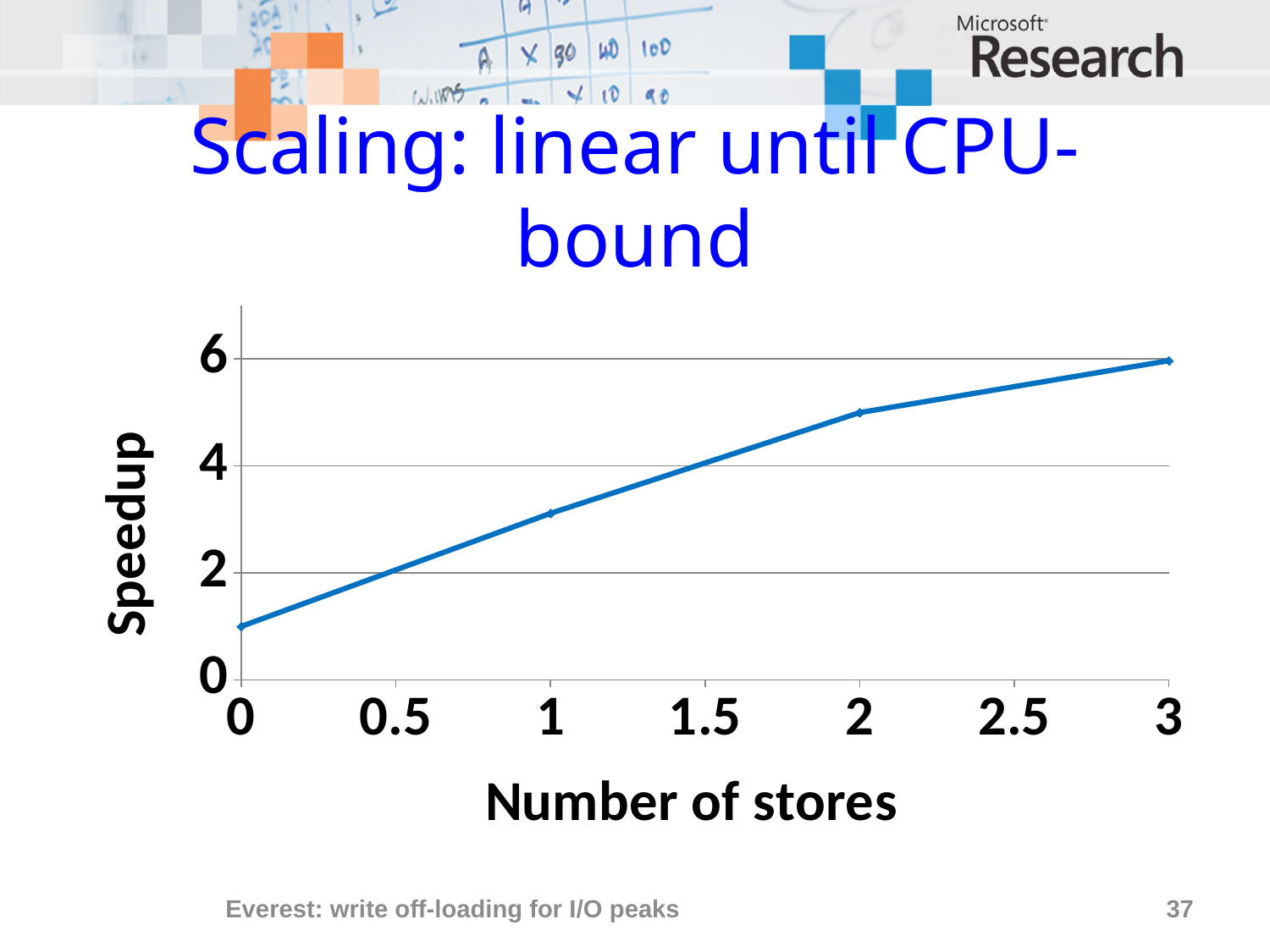
Is the speedup at 2 stores greater or less than 4? greater Does the speedup rise or fall as the number of stores increases? rise What is the label of the x axis? Number of stores At which number of stores is the speedup lowest? 0 Which has the larger speedup: 2 stores or 1 store? 2 stores At which number of stores is the speedup highest? 3 Is the speedup at 0 stores greater or less than 2? less How many data points are plotted on the line? 4 What is the label of the y axis? Speedup What kind of chart is shown on the slide? line chart Is the speedup at 1 store greater or less than 2? greater